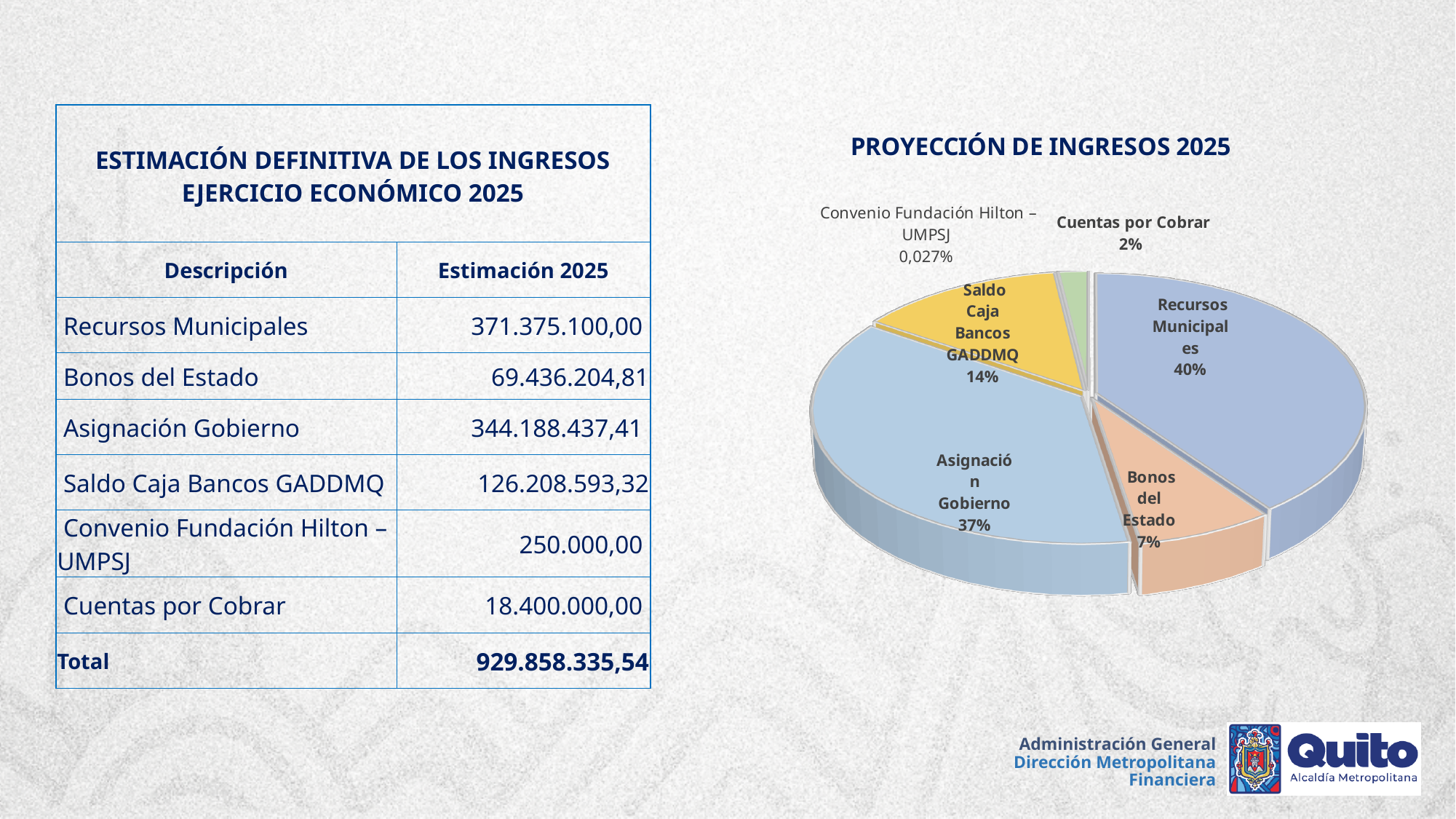
What percentage is shown for Convenio Fundación Hilton – UMPSJ in the pie chart? 0,027% What is the difference in percentage points between Recursos Municipales and Asignación Gobierno? 3% Which category has the smallest slice in the pie chart? Convenio Fundación Hilton – UMPSJ How many slices does the pie chart have? 6 What is the title of the pie chart? PROYECCIÓN DE INGRESOS 2025 What share of the pie does Recursos Municipales represent? 40% Which is larger in the pie chart, Saldo Caja Bancos GADDMQ or Bonos del Estado? Saldo Caja Bancos GADDMQ Which category has the largest slice in the pie chart? Recursos Municipales What kind of chart is shown on the slide? pie chart What share of the pie does Asignación Gobierno represent? 37% What percentage is shown for Bonos del Estado in the pie chart? 7% What percentage is shown for Saldo Caja Bancos GADDMQ in the pie chart? 14%